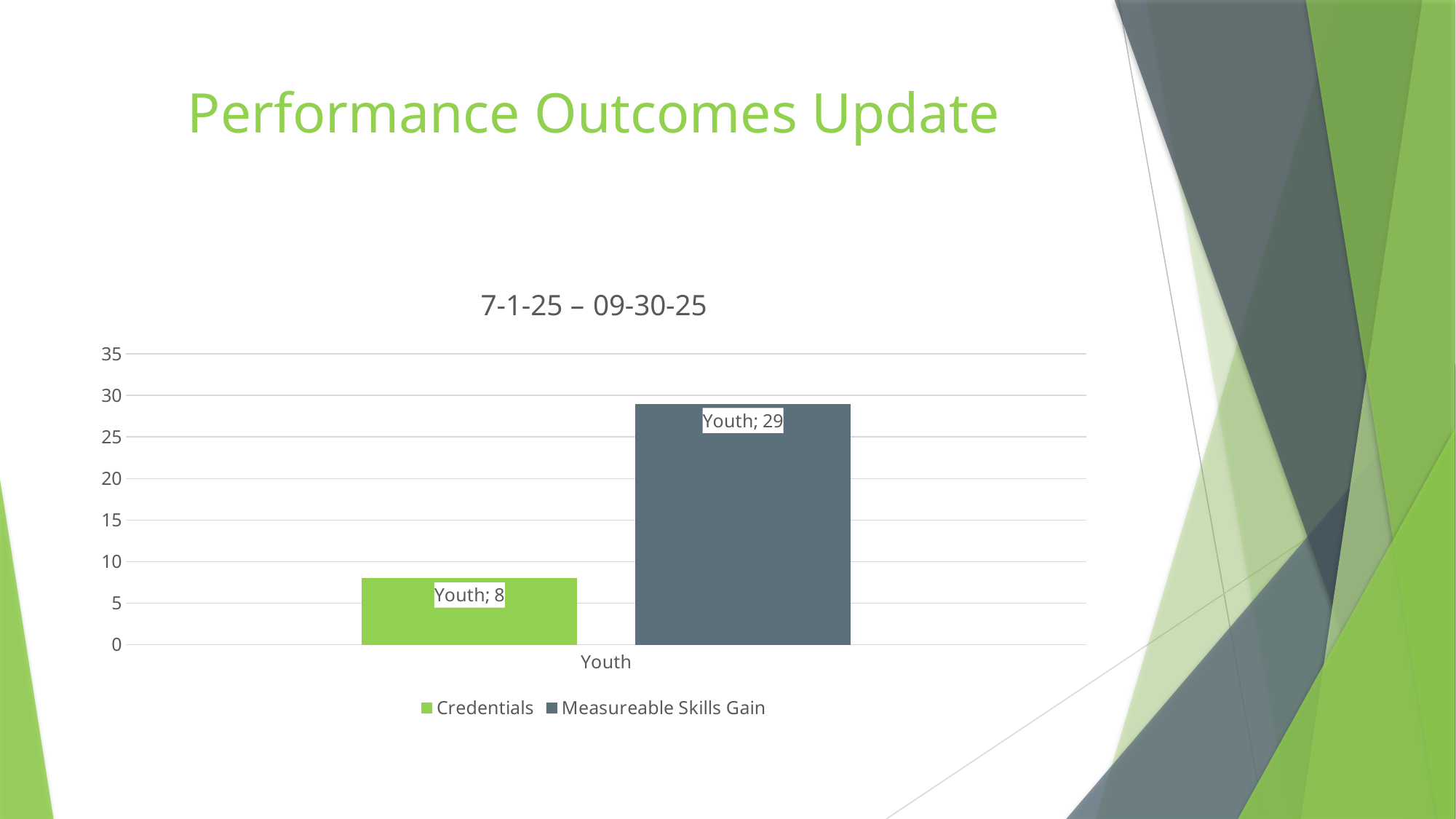
What is the title of the chart? 7-1-25 – 09-30-25 How many series does the legend list? 2 What is the difference between the Measureable Skills Gain value and the Credentials value for Youth? 21 Is the value for Credentials greater or less than 10? less Is the value for Measureable Skills Gain greater or less than 25? greater Which series has the higher value for Youth, Credentials or Measureable Skills Gain? Measureable Skills Gain What colour is the Credentials bar? Green What is the value for Credentials for Youth? 8 What is the value for Measureable Skills Gain for Youth? 29 How many categories are shown on the x axis? 1 What kind of chart is shown on the slide? Bar chart Which series has the lowest value on the chart? Credentials